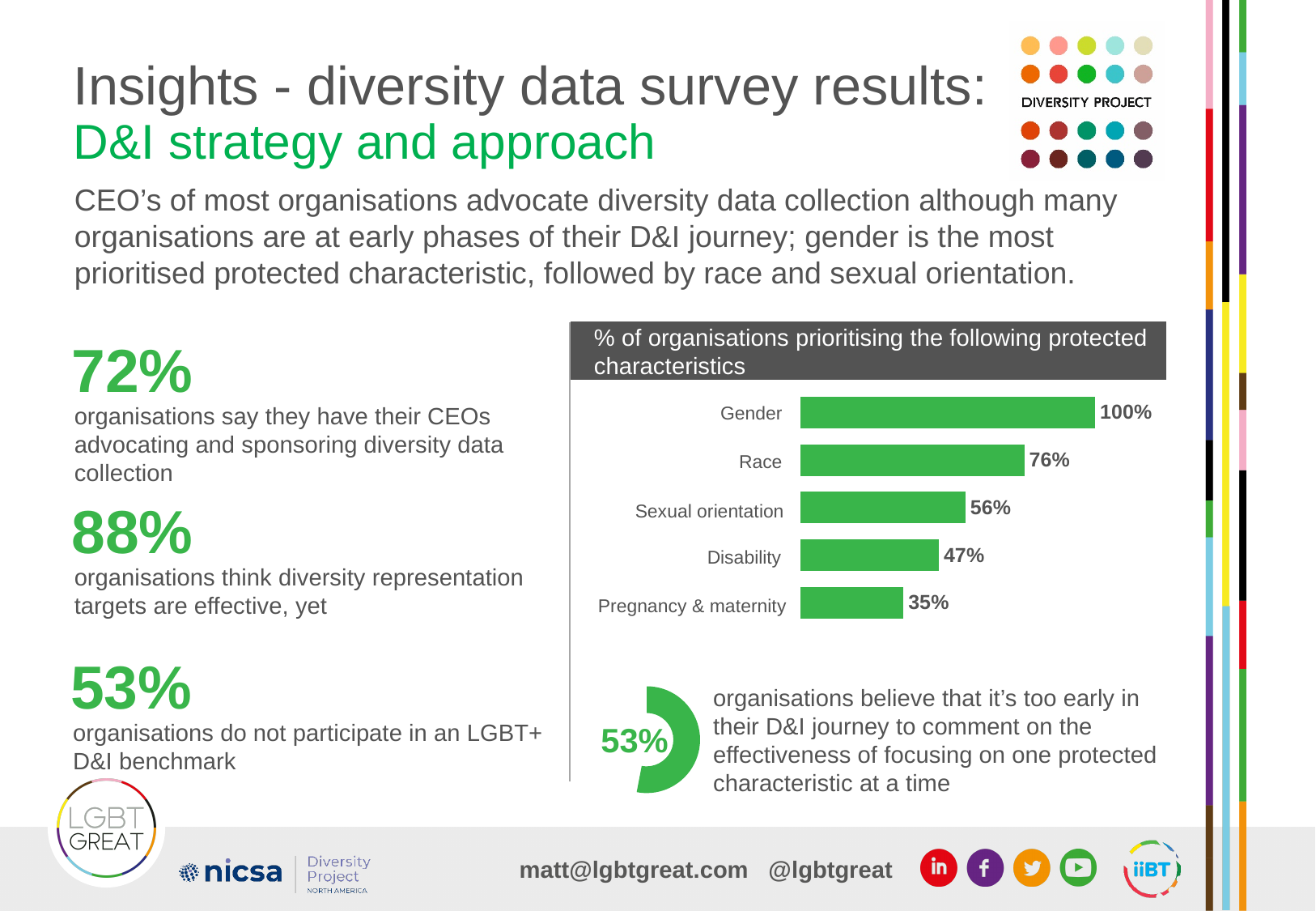
Which protected characteristic has the highest percentage in the bar chart? Gender What is the value shown for Pregnancy & maternity? 35% Which has a higher percentage, Sexual orientation or Disability? Sexual orientation How many protected characteristics are shown in the bar chart? 5 What percentage of organisations prioritise Gender as a protected characteristic? 100% What is the value shown for Race in the bar chart? 76% What is the title of the bar chart? % of organisations prioritising the following protected characteristics What is the difference between the percentages for Gender and Race? 24% What is the difference between the percentages for Disability and Pregnancy & maternity? 12% What type of chart is used to show the percentage of organisations prioritising protected characteristics? Bar chart Which protected characteristic has the lowest percentage in the bar chart? Pregnancy & maternity What percentage of organisations prioritise Sexual orientation? 56%